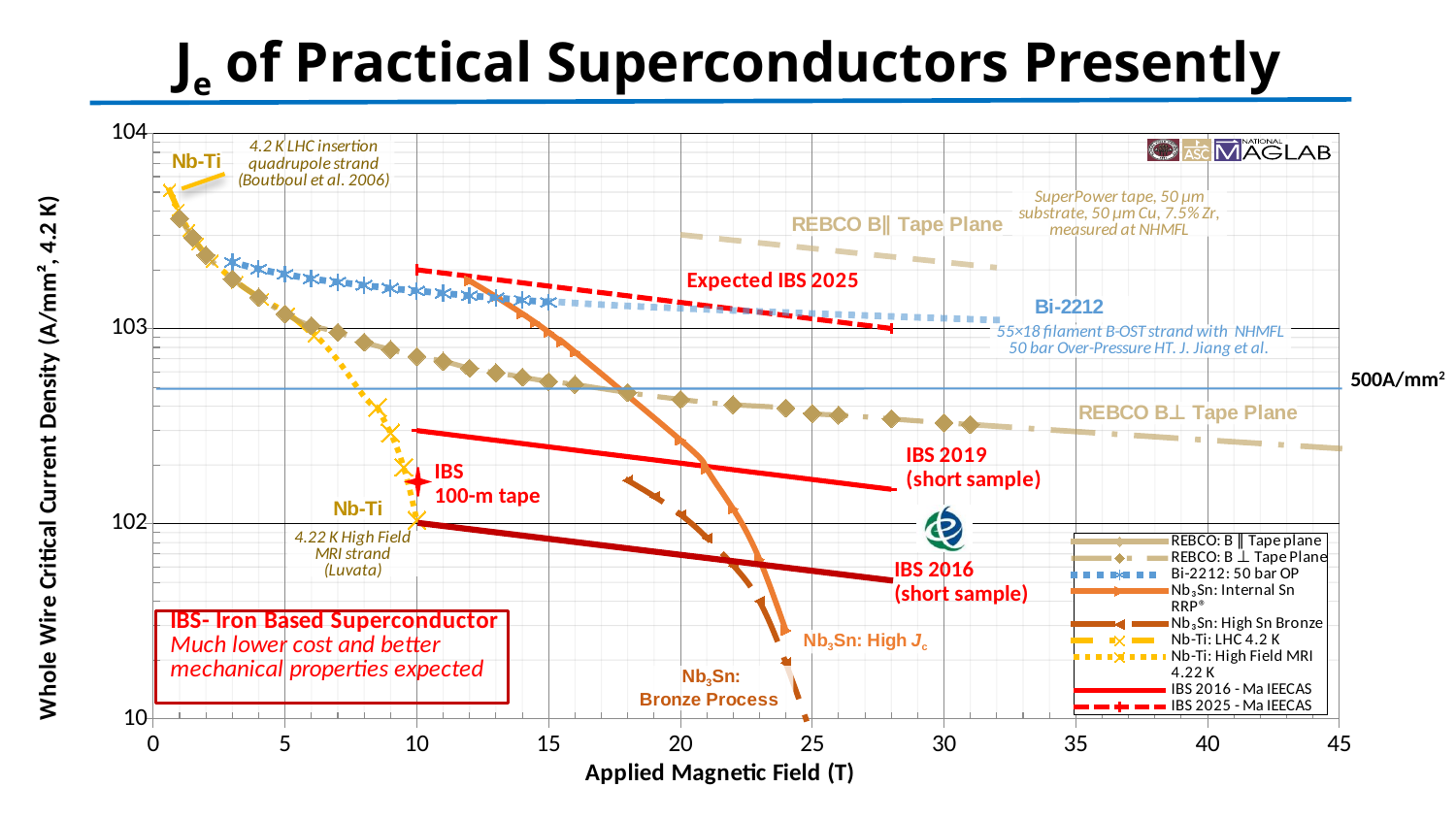
Does the IBS 2016 (short sample) curve rise or fall as the applied magnetic field increases? fall Is the value for REBCO B⊥ Tape Plane at 40 T greater or less than 500? less How many series does the chart legend list? 9 At 20 T, which is higher: REBCO B∥ Tape Plane or REBCO B⊥ Tape Plane? REBCO B∥ Tape Plane Is the value for Bi-2212 at 20 T greater or less than 1000? greater What value is marked by the horizontal blue reference line on the chart? 500A/mm² Is the value for Nb3Sn: High Jc (Internal Sn RRP) at 24 T greater or less than 100? less What is the label of the x axis? Applied Magnetic Field (T) At 20 T, which is higher: IBS 2019 (short sample) or IBS 2016 (short sample)? IBS 2019 (short sample) What kind of chart is shown on the slide? line chart